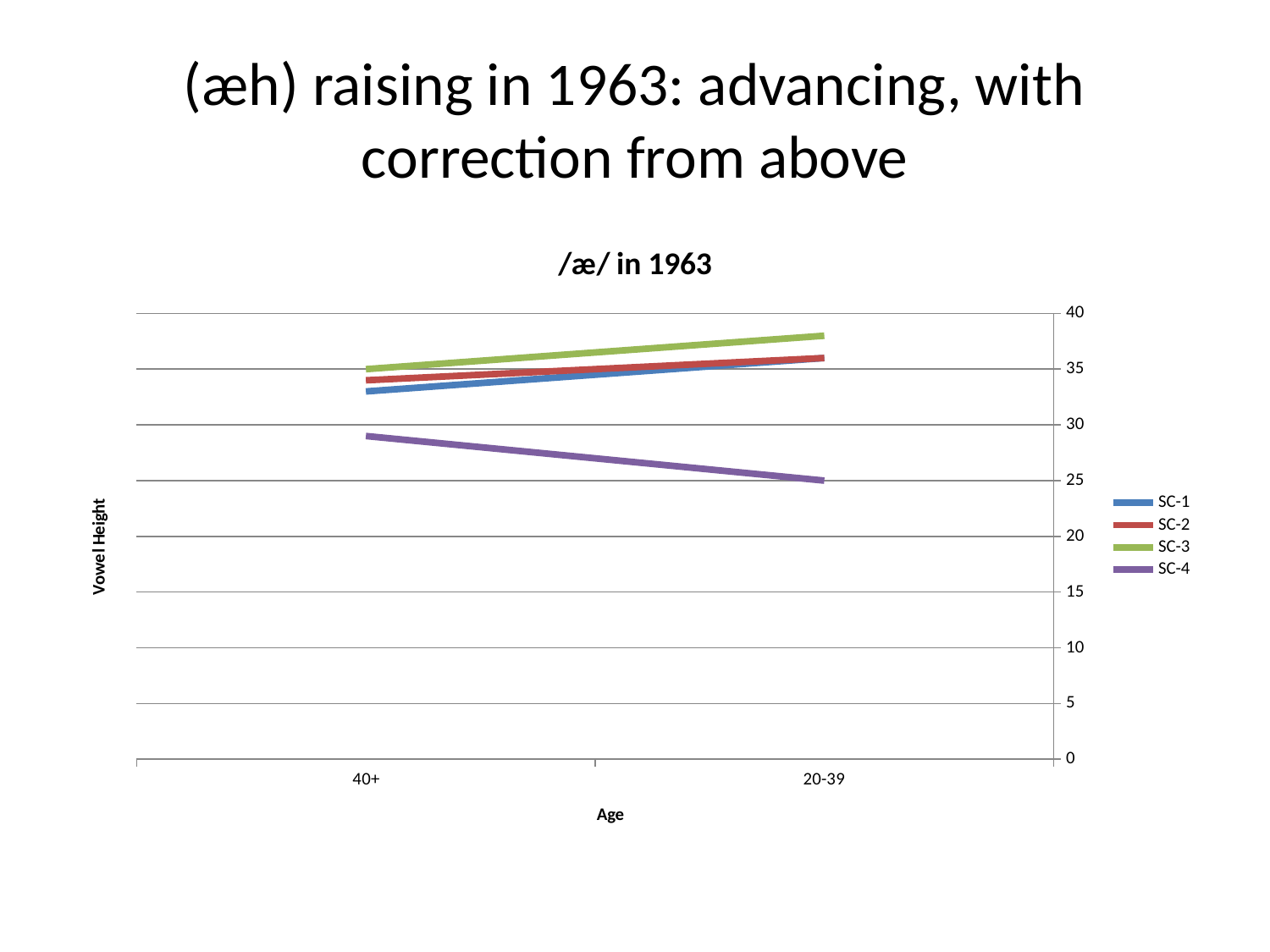
Which series has the lowest vowel height at age 40+? SC-4 Is the value for SC-1 at age 40+ greater or less than 30? greater What is the title of the chart? /æ/ in 1963 At age 20-39, which is larger, SC-3 or SC-4? SC-3 How many series does the legend list? 4 Does the SC-4 line rise or fall from 40+ to 20-39? fall How many age categories are shown on the x axis? 2 Which series has the highest vowel height at age 20-39? SC-3 What kind of chart is shown on the slide? line chart What is the label of the vertical axis? Vowel Height Does the SC-3 line rise or fall from 40+ to 20-39? rise Is the value for SC-4 at age 40+ greater or less than 30? less